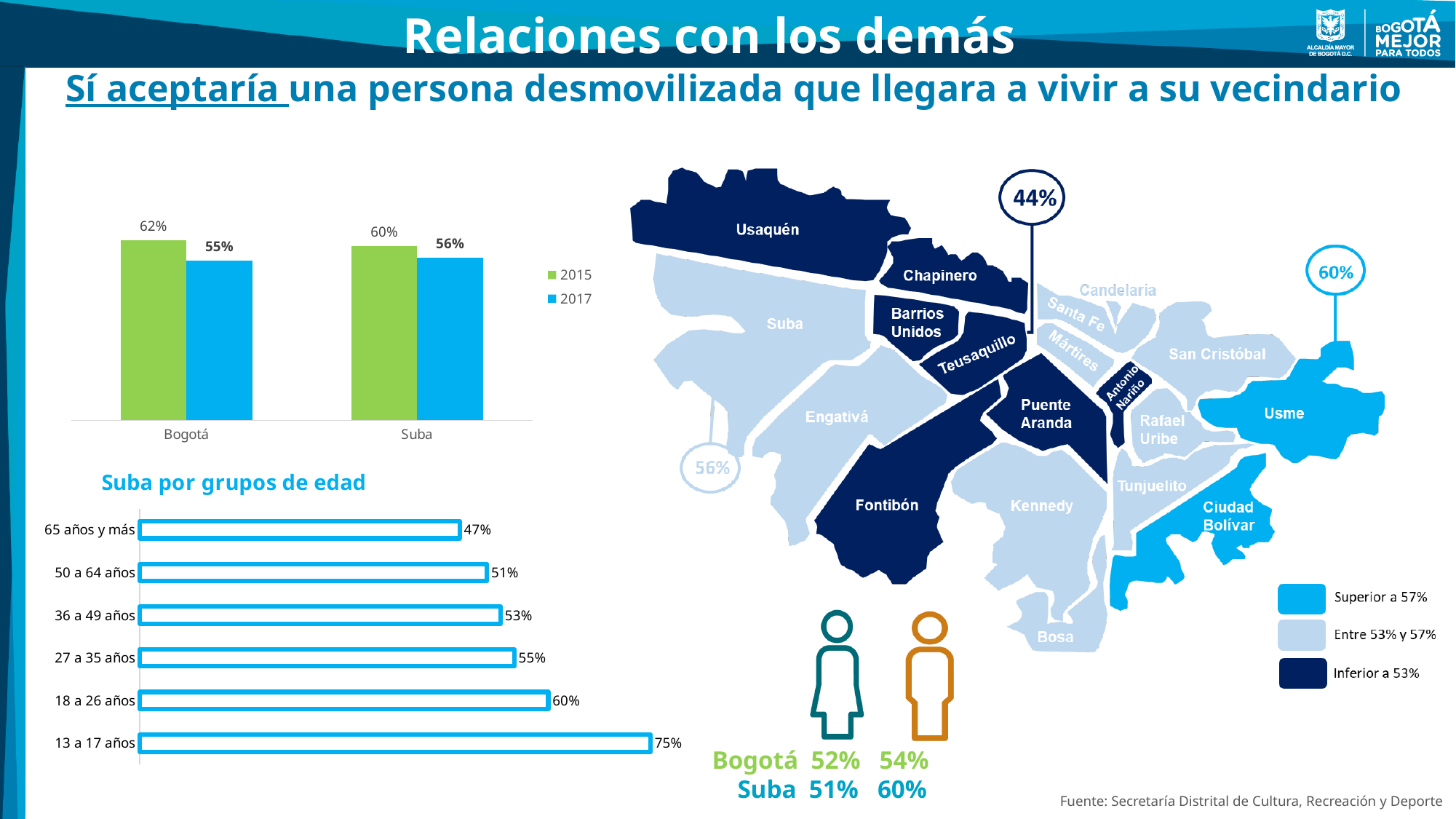
In the top-left bar chart comparing Bogotá and Suba, what kind of chart is it? Bar chart In the 'Suba por grupos de edad' chart, which age group has the lowest value? 65 años y más In the 'Suba por grupos de edad' chart, how many age groups are shown? 6 In the top-left bar chart comparing Bogotá and Suba, which is larger: Bogotá 2015 or Suba 2015? Bogotá 2015 In the top-left bar chart comparing Bogotá and Suba, how many series does the legend list? 2 In the 'Suba por grupos de edad' chart, what is the difference between the values for 18 a 26 años and 50 a 64 años? 9 percentage points In the top-left bar chart comparing Bogotá and Suba, what is the difference between the 2015 and 2017 values for Bogotá? 7 percentage points In the 'Suba por grupos de edad' chart, what is the value for 36 a 49 años? 53% In the top-left bar chart comparing Bogotá and Suba, what is the value for Bogotá in 2017? 55% In the top-left bar chart comparing Bogotá and Suba, what is the value for Suba in 2015? 60% In the 'Suba por grupos de edad' chart, what is the value for 13 a 17 años? 75% In the 'Suba por grupos de edad' chart, which age group has the highest value? 13 a 17 años